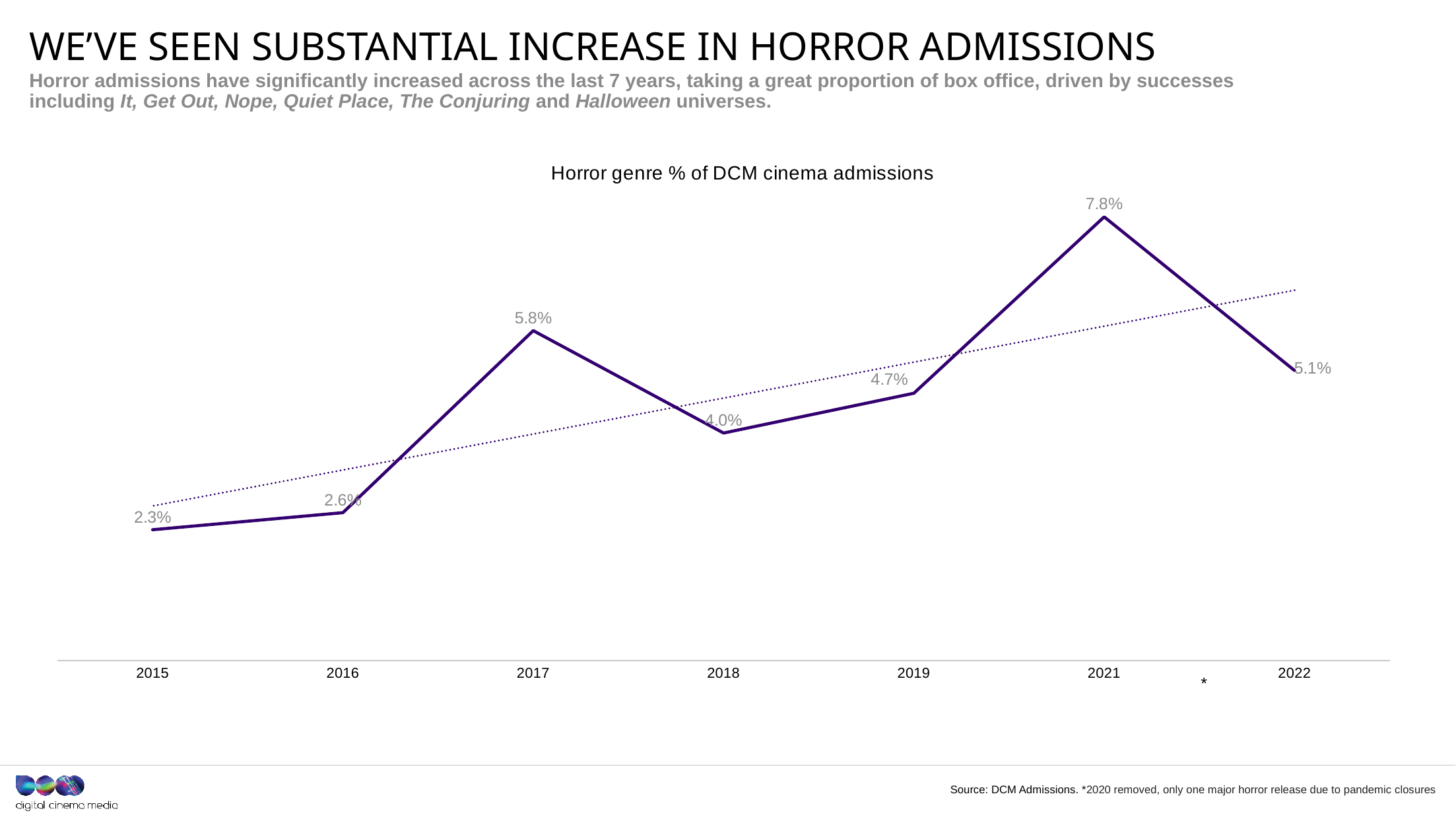
What is the horror genre % of DCM cinema admissions in 2021? 7.8% Which year has the highest horror genre % of DCM cinema admissions? 2021 What is the horror genre % of DCM cinema admissions in 2015? 2.3% What is the horror genre % of DCM cinema admissions in 2018? 4.0% What is the title of the chart? Horror genre % of DCM cinema admissions Which year has the lowest horror genre % of DCM cinema admissions? 2015 What kind of chart is shown on the slide? Line chart How many years are plotted on the chart? 7 What is the difference between the horror genre % in 2021 and in 2022? 2.7% Which year has a higher horror genre % of admissions, 2017 or 2019? 2017 What is the difference between the horror genre % in 2017 and in 2018? 1.8% What is the horror genre % of DCM cinema admissions in 2022? 5.1%